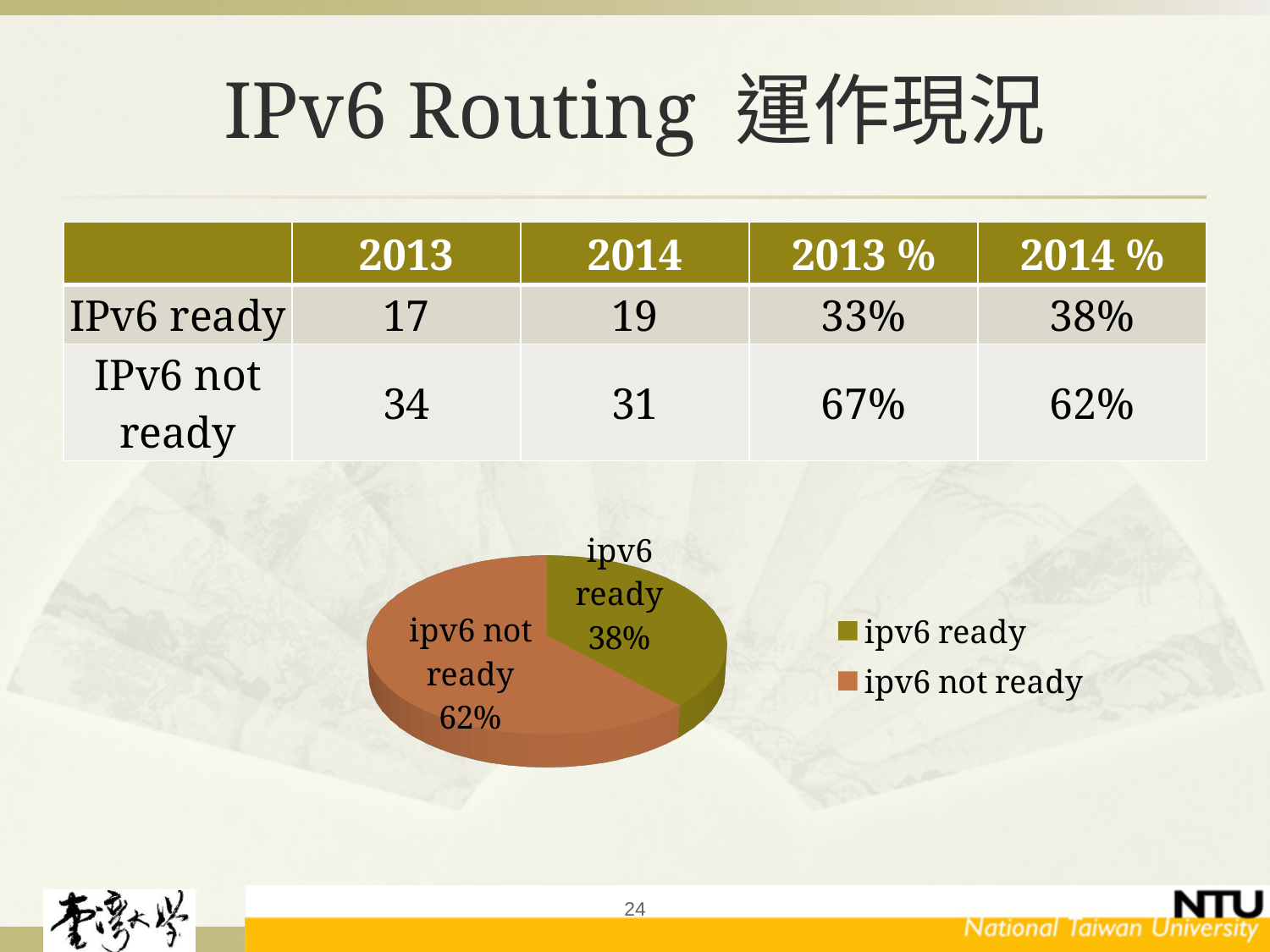
How many entries does the pie chart's legend list? 2 What kind of chart is shown on the slide? pie chart Which legend entry in the pie chart is shown in the brown/orange colour? ipv6 not ready What is the difference in percentage points between the "ipv6 not ready" slice and the "ipv6 ready" slice? 24 Which slice of the pie chart is the largest? ipv6 not ready How many slices does the pie chart have? 2 Which is larger in the pie chart, "ipv6 ready" or "ipv6 not ready"? ipv6 not ready Which legend entry in the pie chart is shown in the olive green colour? ipv6 ready Which slice of the pie chart is the smallest? ipv6 ready What share of the pie chart is labelled "ipv6 not ready"? 62% What share of the pie chart is labelled "ipv6 ready"? 38% What is the combined share of the two slices in the pie chart? 100%